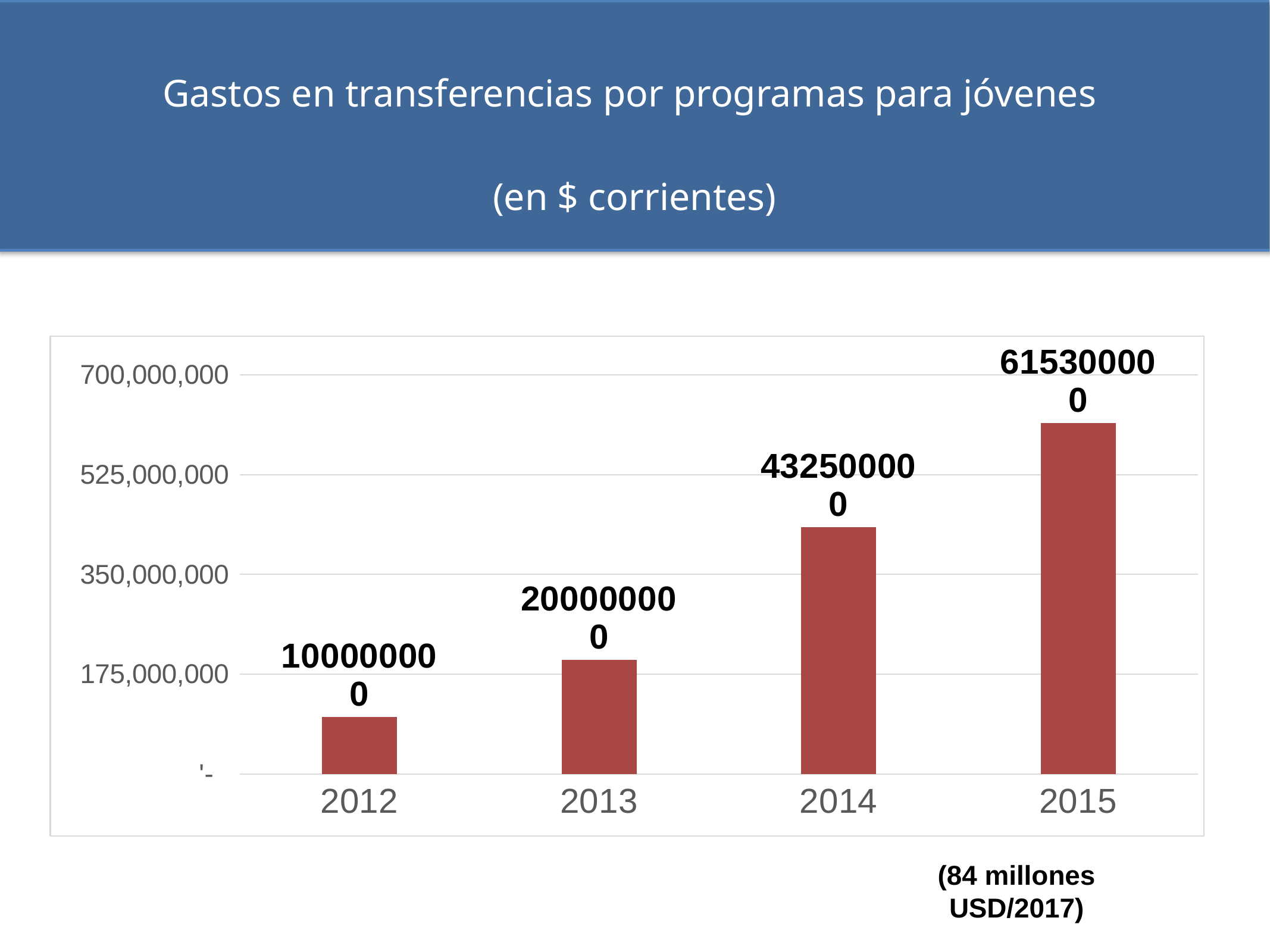
What is the value for 2014? 432500000 How many years are shown on the x axis? 4 Which is larger, the value for 2013 or the value for 2014? 2014 Which year has the highest value? 2015 Is the value for 2014 greater or less than 350,000,000? greater Which year has the lowest value? 2012 Do the values rise or fall from 2012 to 2015? rise What is the value for 2015? 615300000 What is the difference between the values for 2013 and 2012? 100000000 What is the value for 2012? 100000000 What is the difference between the values for 2015 and 2014? 182800000 What kind of chart is shown on the slide? bar chart